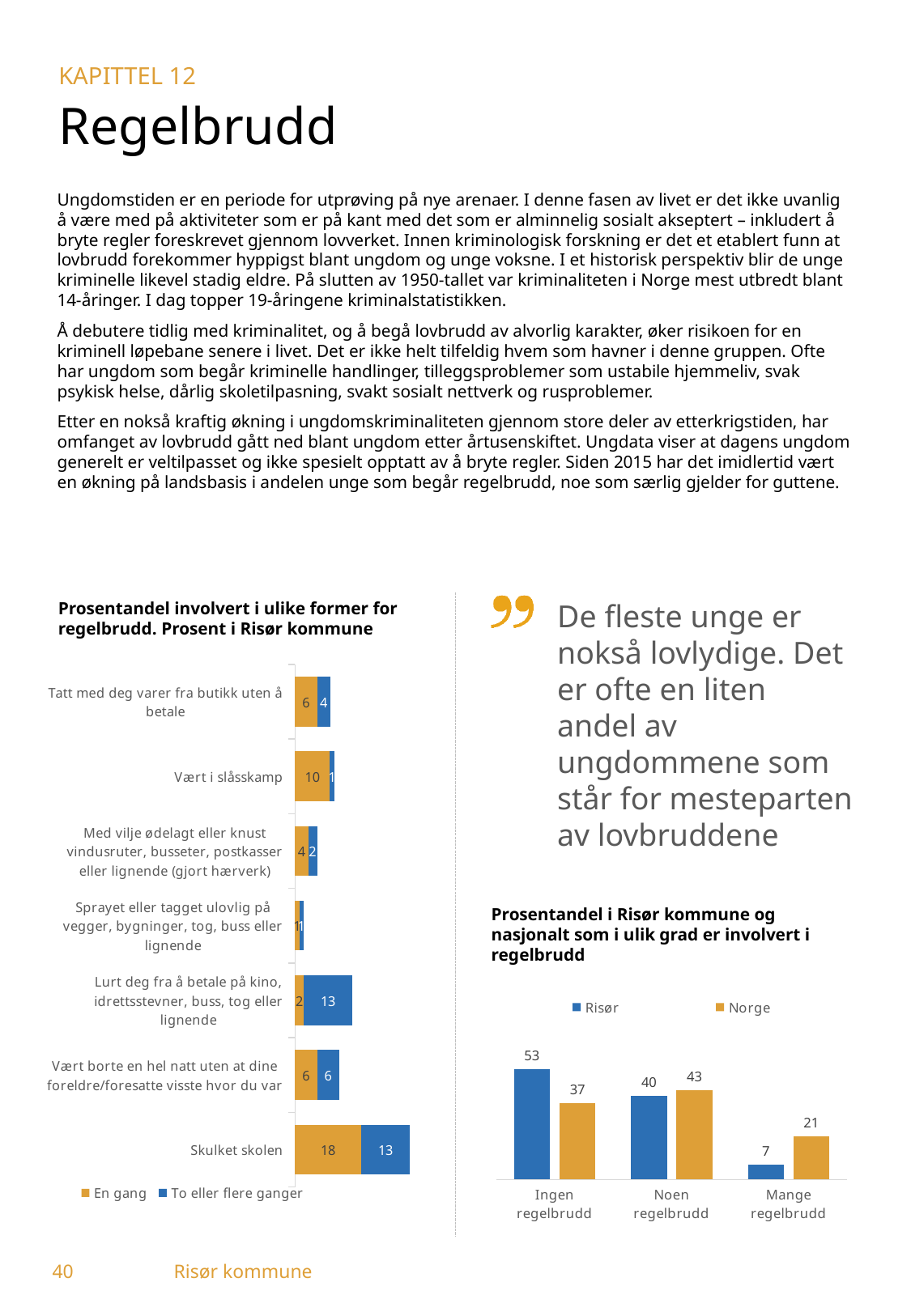
In the chart 'Prosentandel involvert i ulike former for regelbrudd. Prosent i Risør kommune', what is the total of the stacked bar for 'Skulket skolen'? 31 In the chart 'Prosentandel involvert i ulike former for regelbrudd. Prosent i Risør kommune', how many categories are shown? 7 In the chart 'Prosentandel i Risør kommune og nasjonalt som i ulik grad er involvert i regelbrudd', what is the difference between Risør and Norge for 'Ingen regelbrudd'? 16 In the chart 'Prosentandel involvert i ulike former for regelbrudd. Prosent i Risør kommune', how many series does the legend list? 2 In the chart 'Prosentandel involvert i ulike former for regelbrudd. Prosent i Risør kommune', what is the total of the stacked bar for 'Vært i slåsskamp'? 11 What kind of chart is 'Prosentandel i Risør kommune og nasjonalt som i ulik grad er involvert i regelbrudd'? Bar chart In the chart 'Prosentandel involvert i ulike former for regelbrudd. Prosent i Risør kommune', which category has the highest 'En gang' value? Skulket skolen In the chart 'Prosentandel i Risør kommune og nasjonalt som i ulik grad er involvert i regelbrudd', what is the value for Risør in 'Ingen regelbrudd'? 53 In the chart 'Prosentandel i Risør kommune og nasjonalt som i ulik grad er involvert i regelbrudd', which is larger for 'Mange regelbrudd', Risør or Norge? Norge In the chart 'Prosentandel involvert i ulike former for regelbrudd. Prosent i Risør kommune', what is the value of 'En gang' for 'Skulket skolen'? 18 In the chart 'Prosentandel i Risør kommune og nasjonalt som i ulik grad er involvert i regelbrudd', what is the value for Norge in 'Mange regelbrudd'? 21 In the chart 'Prosentandel involvert i ulike former for regelbrudd. Prosent i Risør kommune', what is the value of 'To eller flere ganger' for 'Lurt deg fra å betale på kino, idrettsstevner, buss, tog eller lignende'? 13